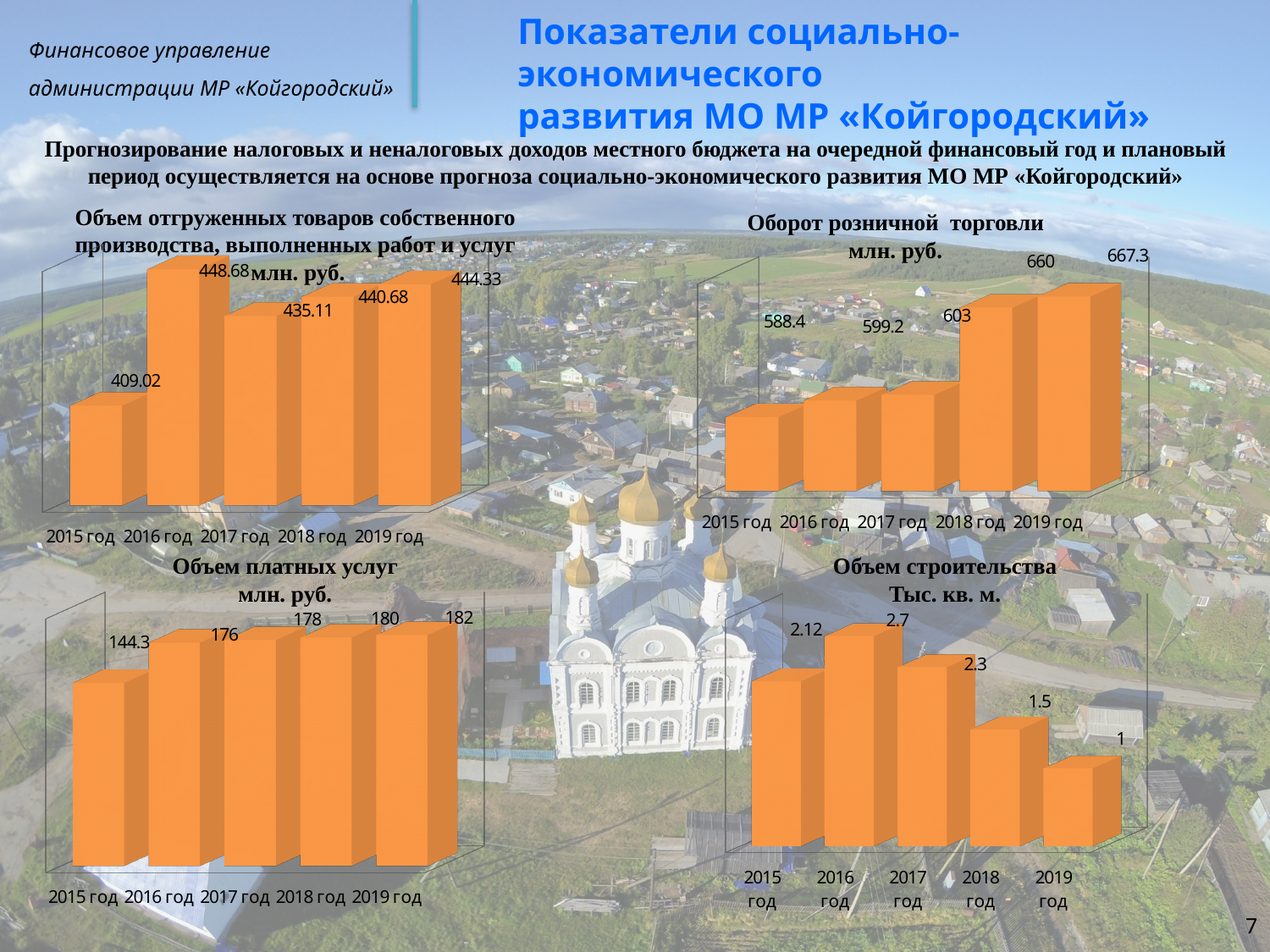
On the 'Оборот розничной торговли' chart, what is the difference between the values for 2018 год and 2017 год? 57 On the 'Объем строительства' chart, which is larger: the value for 2015 год or the value for 2017 год? 2017 год On the 'Объем строительства' chart, which year has the highest value? 2016 год On the 'Объем платных услуг' chart, what is the difference between the values for 2019 год and 2015 год? 37.7 On the 'Объем строительства' chart, what is the value for 2018 год? 1.5 On the 'Объем платных услуг' chart, what is the value for 2016 год? 176 On the 'Объем платных услуг' chart, which year has the lowest value? 2015 год On the 'Объем отгруженных товаров собственного производства, выполненных работ и услуг' chart, which year has the highest value? 2016 год On the 'Оборот розничной торговли' chart, what is the value for 2019 год? 667.3 How many charts are shown on the slide, and what type are they? 4 bar charts On the 'Оборот розничной торговли' chart, do the values rise or fall from 2015 год to 2019 год? rise On the 'Объем отгруженных товаров собственного производства, выполненных работ и услуг' chart, what is the value for 2015 год? 409.02